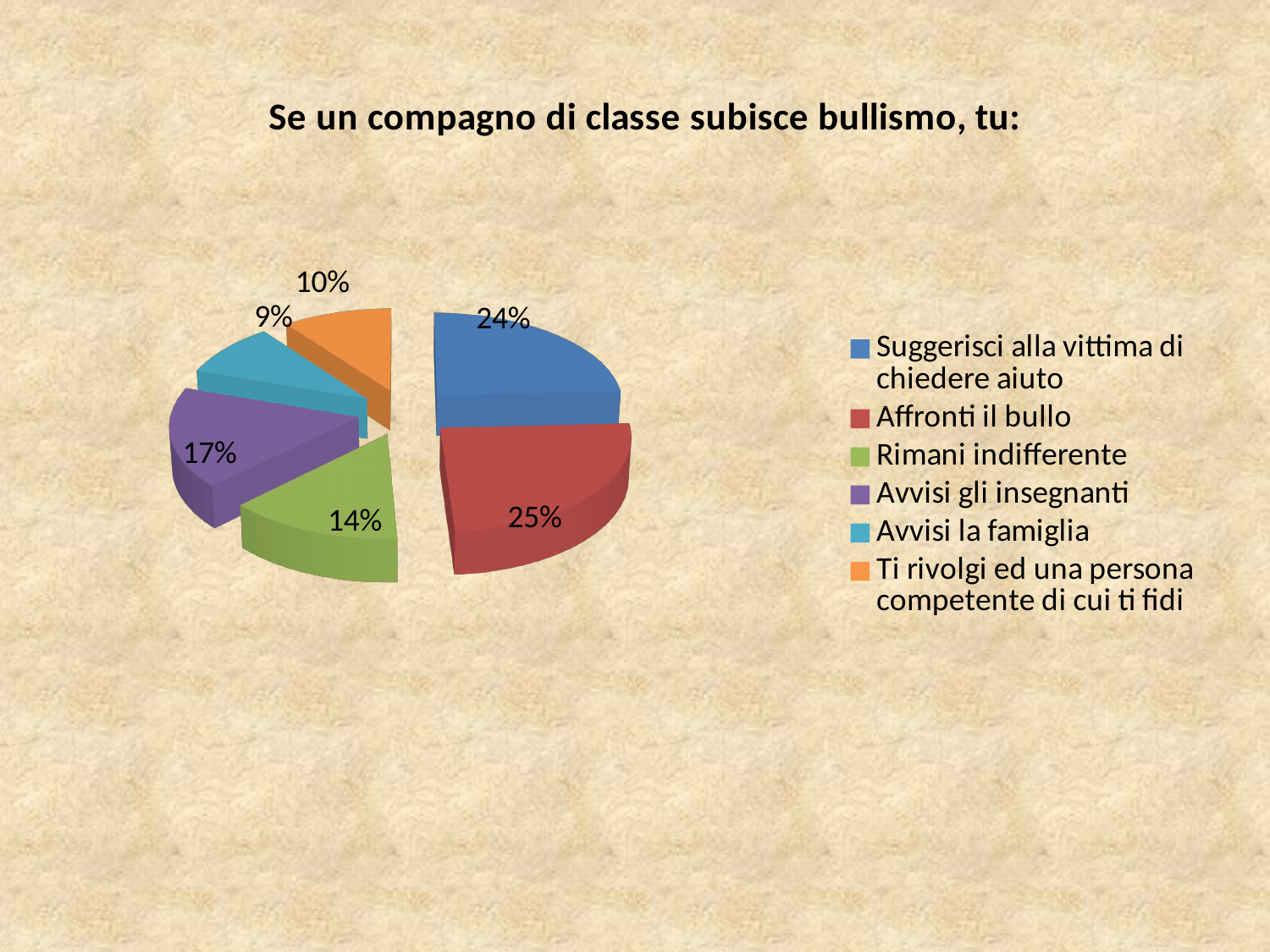
What percentage of the pie is 'Avvisi gli insegnanti'? 17% What percentage of the pie is 'Suggerisci alla vittima di chiedere aiuto'? 24% Which category has the largest share of the pie? Affronti il bullo Which category has the smallest share of the pie? Avvisi la famiglia What percentage of the pie is 'Affronti il bullo'? 25% What is the difference in percentage points between 'Avvisi gli insegnanti' and 'Rimani indifferente'? 3 What kind of chart is shown on the slide? Pie chart How many categories does the pie chart show? 6 Which is larger: 'Rimani indifferente' or 'Ti rivolgi ed una persona competente di cui ti fidi'? Rimani indifferente What percentage of the pie is 'Avvisi la famiglia'? 9% What is the title of the chart? Se un compagno di classe subisce bullismo, tu: Which colour represents 'Rimani indifferente' in the legend? Green